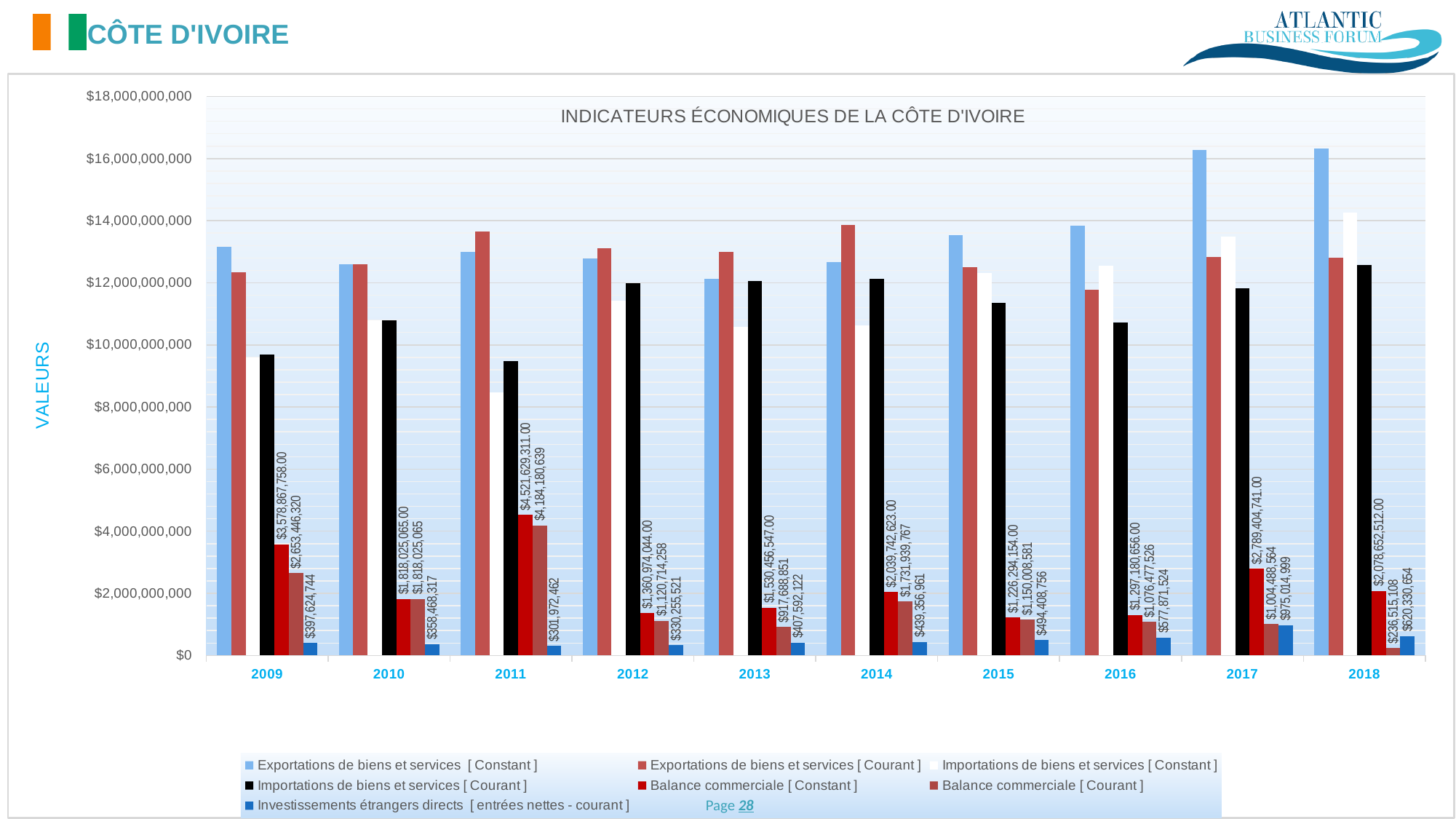
What is the title of the chart? INDICATEURS ÉCONOMIQUES DE LA CÔTE D'IVOIRE Is the value of Exportations de biens et services [ Constant ] for 2017 greater or less than $16,000,000,000? greater How many years are shown on the x axis of the chart? 10 In which year is Balance commerciale [ Courant ] lowest? 2018 What is the value of Investissements étrangers directs [ entrées nettes - courant ] for 2017? $975,014,999 What is the difference between Balance commerciale [ Constant ] and Balance commerciale [ Courant ] in 2009? $925,421,438 Is the value of Importations de biens et services [ Courant ] for 2009 greater or less than $10,000,000,000? less What is the value of Balance commerciale [ Constant ] for 2011? $4,521,629,311.00 In which year is Balance commerciale [ Constant ] highest? 2011 Which year has the larger value for Investissements étrangers directs, 2017 or 2018? 2017 How many series does the chart's legend list? 7 What kind of chart is shown on the slide? bar chart